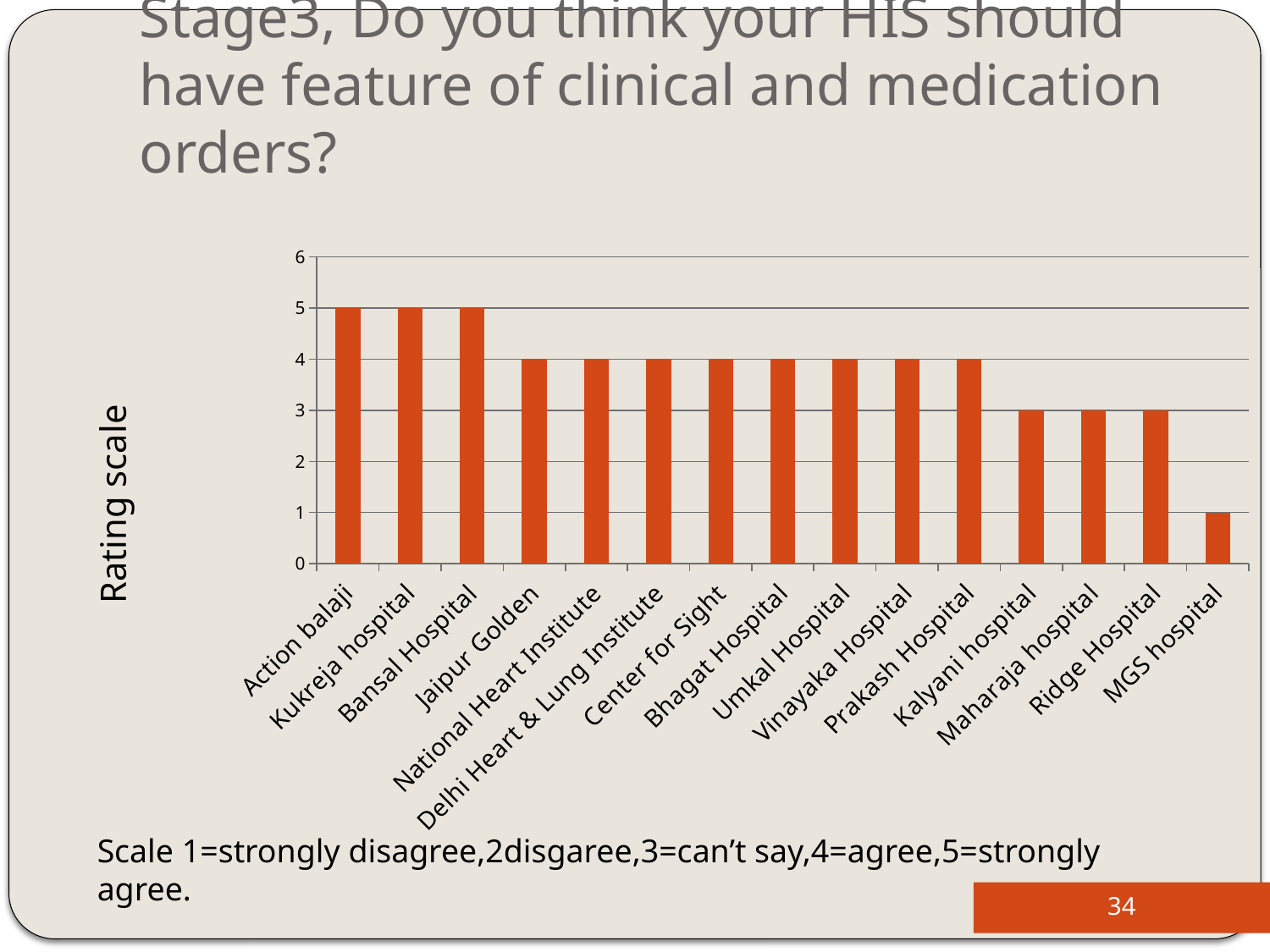
What is the rating for Action balaji? 5 How many hospitals are shown on the x axis of the chart? 15 What is the rating for Delhi Heart & Lung Institute? 4 Is the value for Maharaja hospital greater or less than 4? less What kind of chart is shown on the slide? Bar chart Do the ratings generally rise or fall moving from left to right along the x axis? Fall What is the difference between the ratings for Bansal Hospital and MGS hospital? 4 What is the rating for Kalyani hospital? 3 What is the label of the vertical axis of the chart? Rating scale What is the rating for MGS hospital? 1 Which has a higher rating, Kukreja hospital or Ridge Hospital? Kukreja hospital Which hospital has the lowest rating? MGS hospital